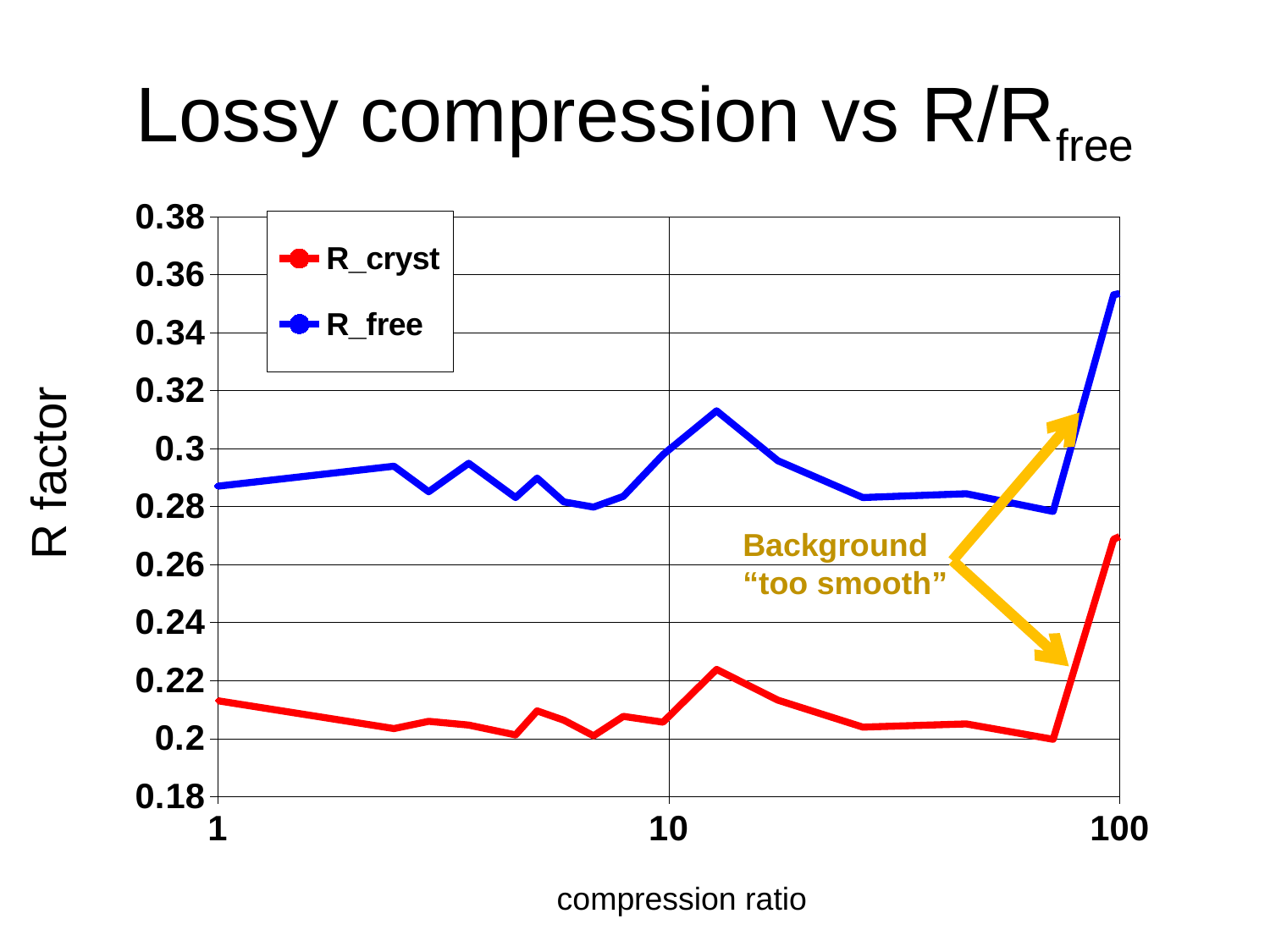
What is the title of the chart on the slide? Lossy compression vs R/Rfree Is the value of R_cryst at a compression ratio of 1 greater or less than 0.22? less How many series does the legend list? 2 At which compression ratio does the R_free series reach its highest value? 100 Which series lies above the other across the whole range of compression ratios? R_free Is the value of R_free at a compression ratio of 10 greater or less than 0.28? greater What kind of chart is shown on the slide? line chart Is the value of R_free at a compression ratio of 100 greater or less than 0.34? greater At a compression ratio of 100, which series has the higher R factor, R_cryst or R_free? R_free What are the two series named in the legend? R_cryst and R_free